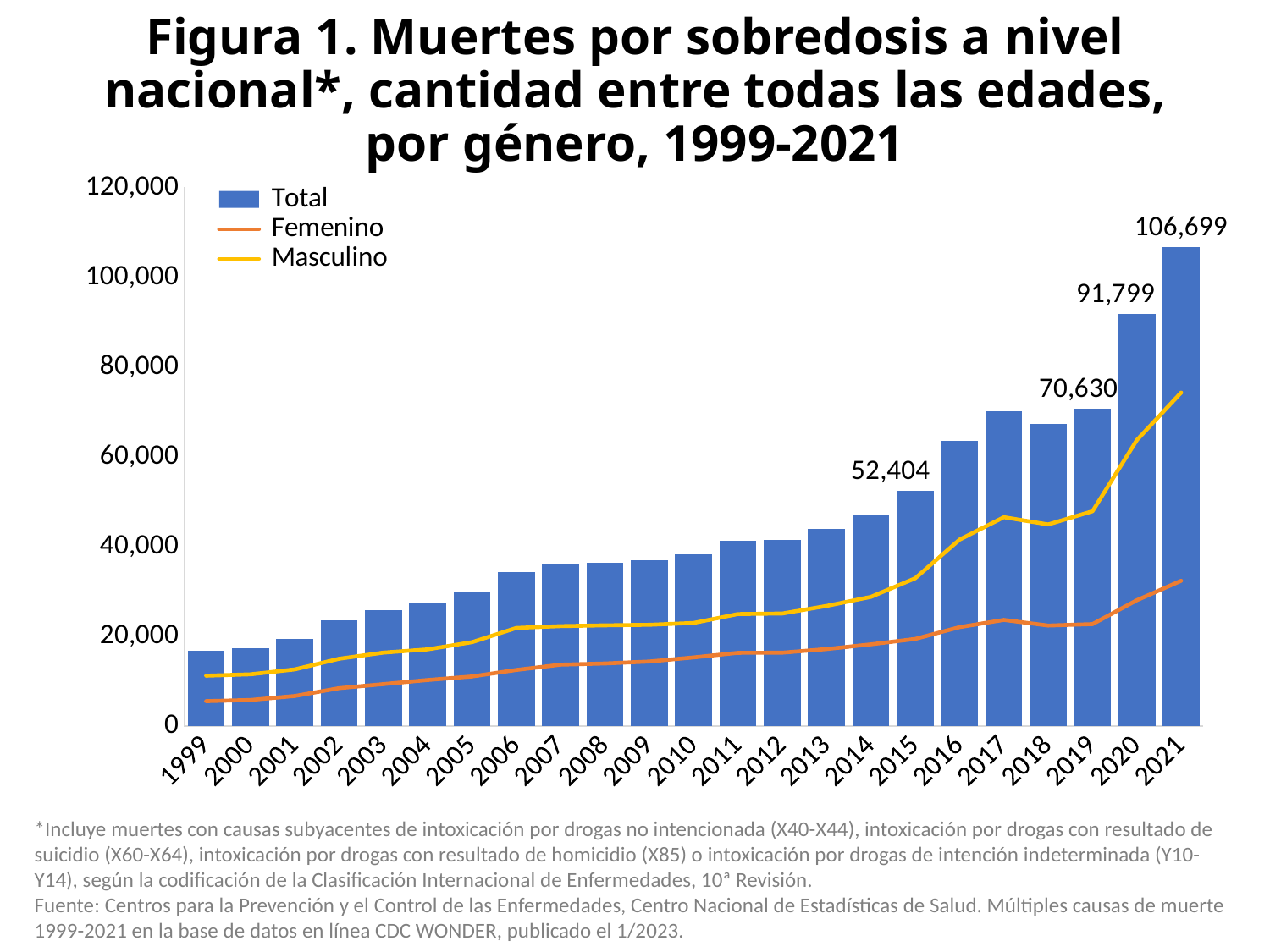
What is the Total value for 2020? 91,799 Which year has the highest Total? 2021 How many years are shown on the x axis? 23 Is the Total value for 2010 greater or less than 40,000? less In 2021, which is larger, the Masculino value or the Femenino value? Masculino What is the difference between the Total for 2021 and the Total for 2020? 14,900 How many series does the legend list? 3 What is the Total value for 2021? 106,699 What is the Total value for 2015? 52,404 Is the Masculino value for 2021 greater or less than 60,000? greater